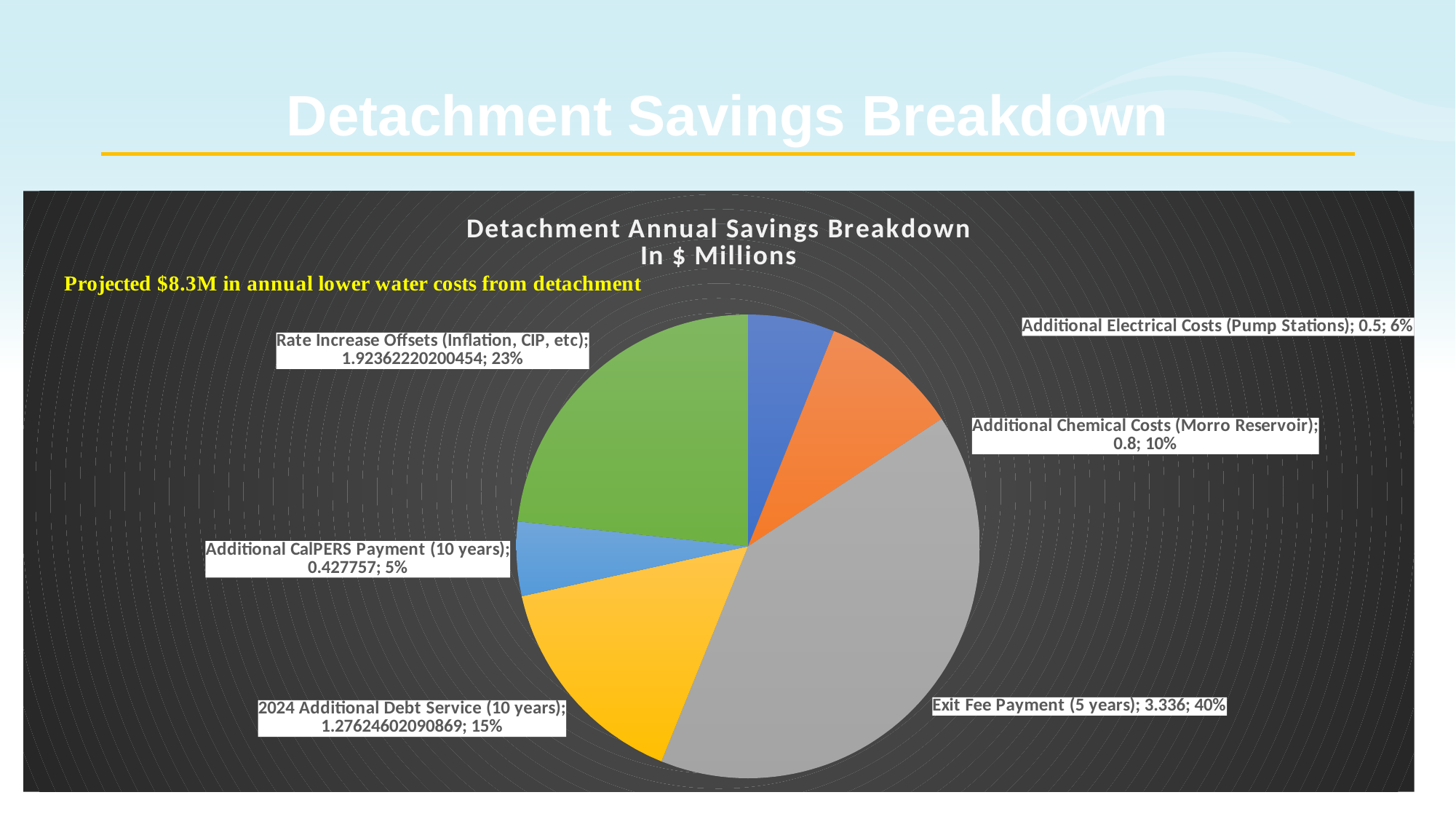
Which category has the smallest slice of the pie? Additional CalPERS Payment (10 years) How many slices does the pie chart have? 6 What percentage share does Exit Fee Payment (5 years) have in the pie chart? 40% What type of chart is shown on the slide? Pie chart Which is larger: the share for 2024 Additional Debt Service (10 years) or the share for Additional Chemical Costs (Morro Reservoir)? 2024 Additional Debt Service (10 years) What is the title of the chart? Detachment Annual Savings Breakdown In $ Millions What value is shown for Exit Fee Payment (5 years)? 3.336 What is the difference in value between Additional Chemical Costs (Morro Reservoir) and Additional Electrical Costs (Pump Stations)? 0.3 Which category has the largest slice of the pie? Exit Fee Payment (5 years) What percentage share does Rate Increase Offsets (Inflation, CIP, etc) have? 23% What value is shown for Additional Chemical Costs (Morro Reservoir)? 0.8 What percentage share does Additional Electrical Costs (Pump Stations) have? 6%